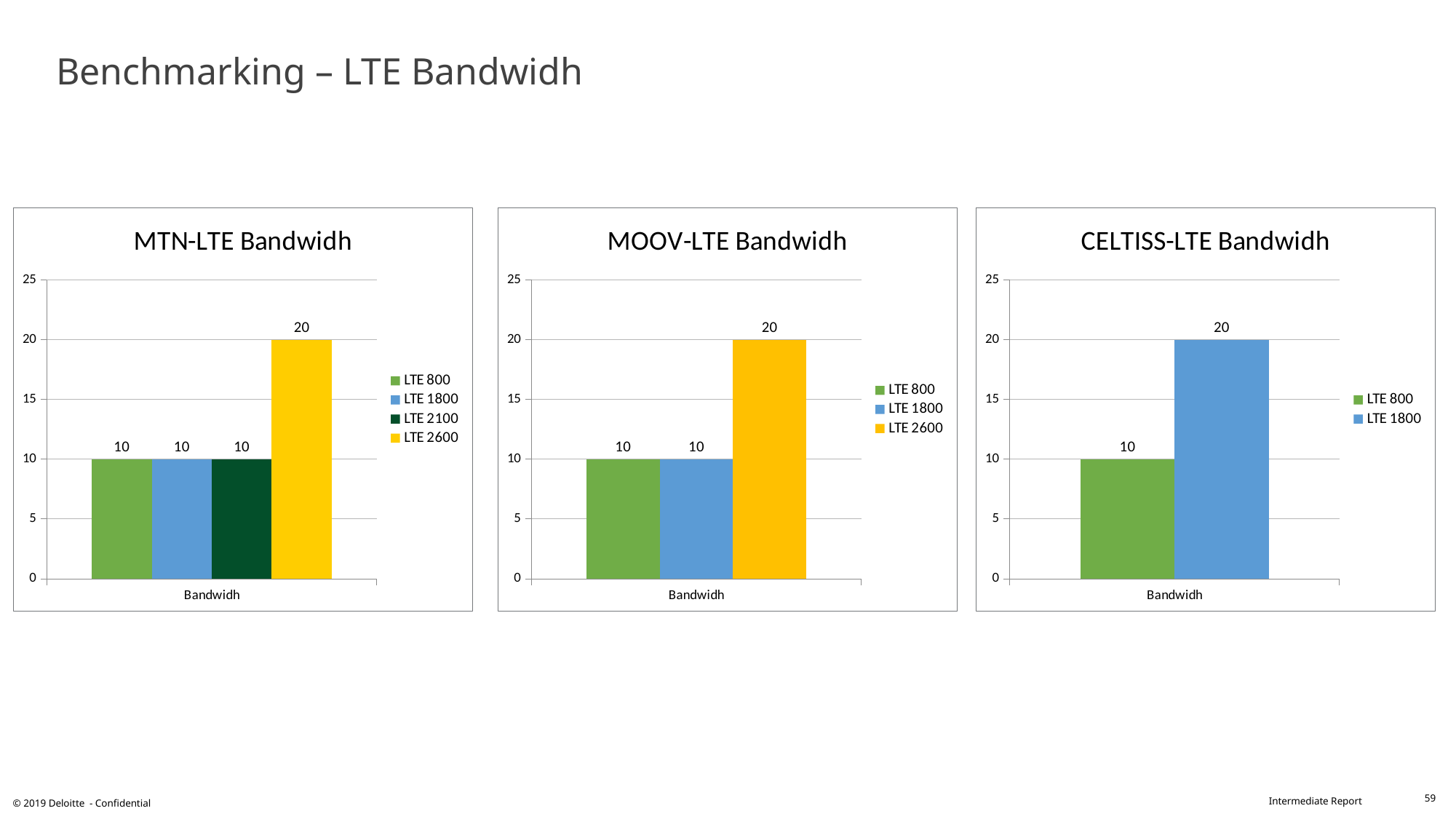
In the CELTISS-LTE Bandwidh chart, what is the value for LTE 1800? 20 In the MTN-LTE Bandwidh chart, what is the difference between the LTE 2600 value and the LTE 800 value? 10 In the MOOV-LTE Bandwidh chart, how many series does the legend list? 3 In the MTN-LTE Bandwidh chart, which series has the highest value? LTE 2600 In the MTN-LTE Bandwidh chart, what is the value for LTE 2100? 10 In the MOOV-LTE Bandwidh chart, what is the value for LTE 1800? 10 In the MTN-LTE Bandwidh chart, what colour is the LTE 2600 bar? Yellow In the MTN-LTE Bandwidh chart, how many series does the legend list? 4 What kind of chart is the CELTISS-LTE Bandwidh chart? Bar chart In the MOOV-LTE Bandwidh chart, which series has the highest value? LTE 2600 In the CELTISS-LTE Bandwidh chart, which is larger, LTE 800 or LTE 1800? LTE 1800 In the MTN-LTE Bandwidh chart, what is the value for LTE 2600? 20